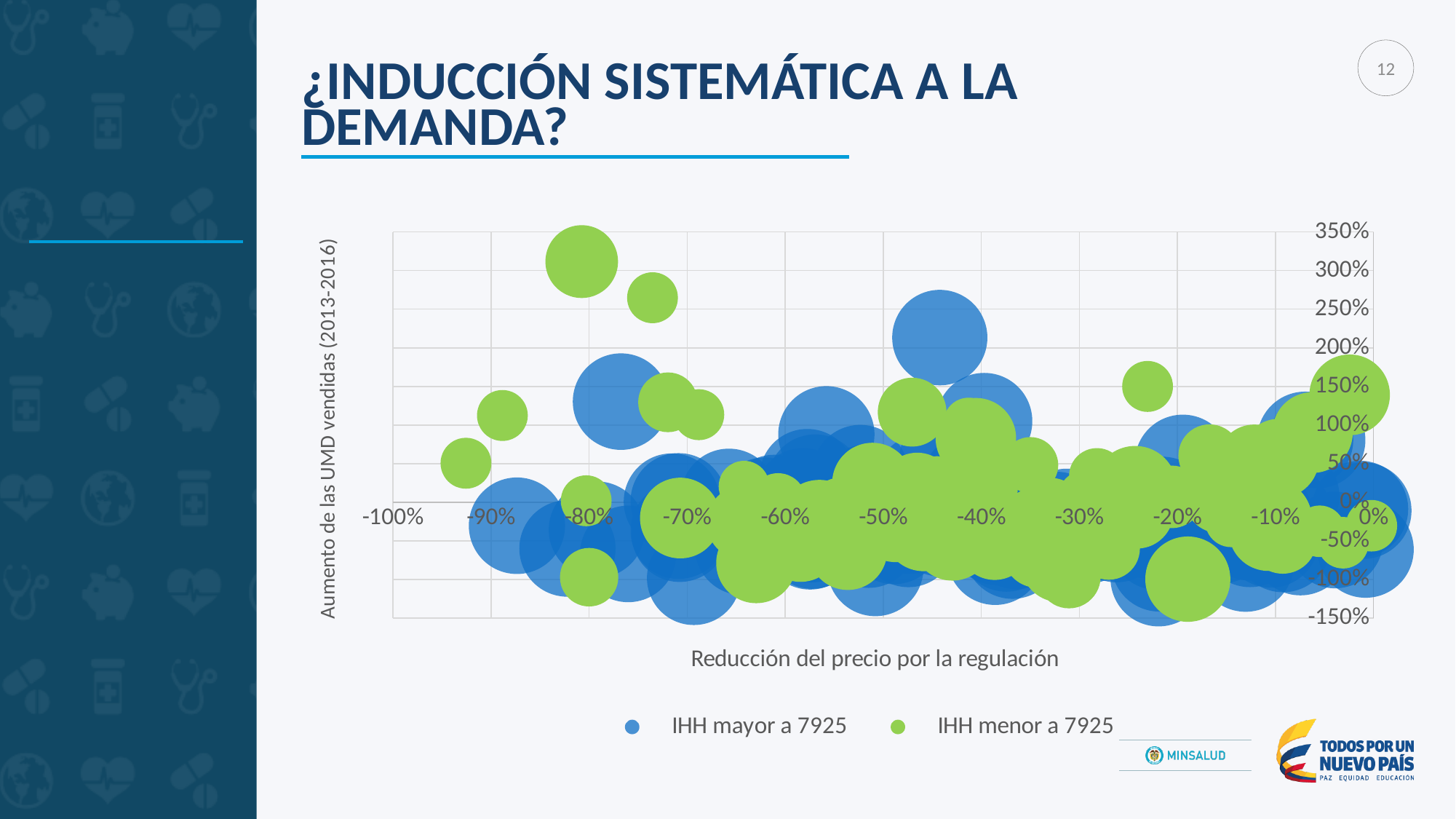
Which colour represents the series 'IHH menor a 7925'? Green What is the lowest value shown on the vertical axis? -150% What kind of chart is shown on the slide? Bubble chart Is the vertical-axis value of the highest blue bubble (near -45% on the horizontal axis) greater or less than 150%? greater What is the highest value shown on the vertical axis? 350% What is the title of the horizontal axis? Reducción del precio por la regulación How many series does the legend list? 2 Is the vertical-axis value of the highest green bubble (near -80% on the horizontal axis) greater or less than 250%? greater What is the leftmost tick label on the horizontal axis? -100% What are the two series named in the legend? IHH mayor a 7925 and IHH menor a 7925 What is the title of the vertical axis? Aumento de las UMD vendidas (2013-2016) Which series contains the bubble with the highest vertical-axis value? IHH menor a 7925